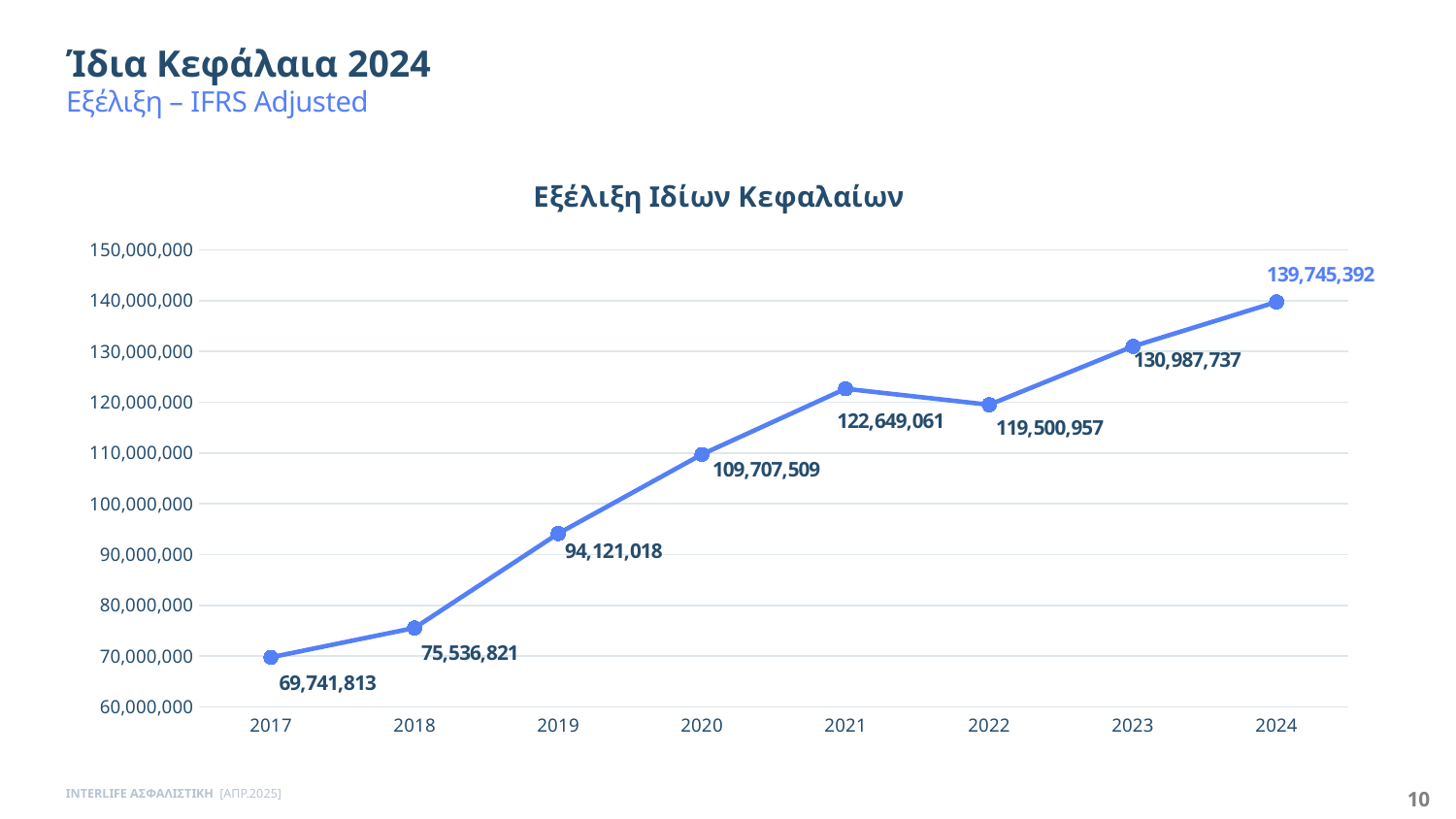
What is the value for 2017? 69,741,813 What is the value for 2024? 139,745,392 What is the title of the chart? Εξέλιξη Ιδίων Κεφαλαίων Which is larger, the value for 2021 or the value for 2022? 2021 What is the value for 2022? 119,500,957 Which year has the highest value? 2024 How many years are plotted on the chart? 8 What kind of chart is shown? Line chart What is the difference between the values for 2021 and 2022? 3,148,104 Which year has the lowest value? 2017 What is the value for 2020? 109,707,509 What is the difference between the values for 2024 and 2023? 8,757,655